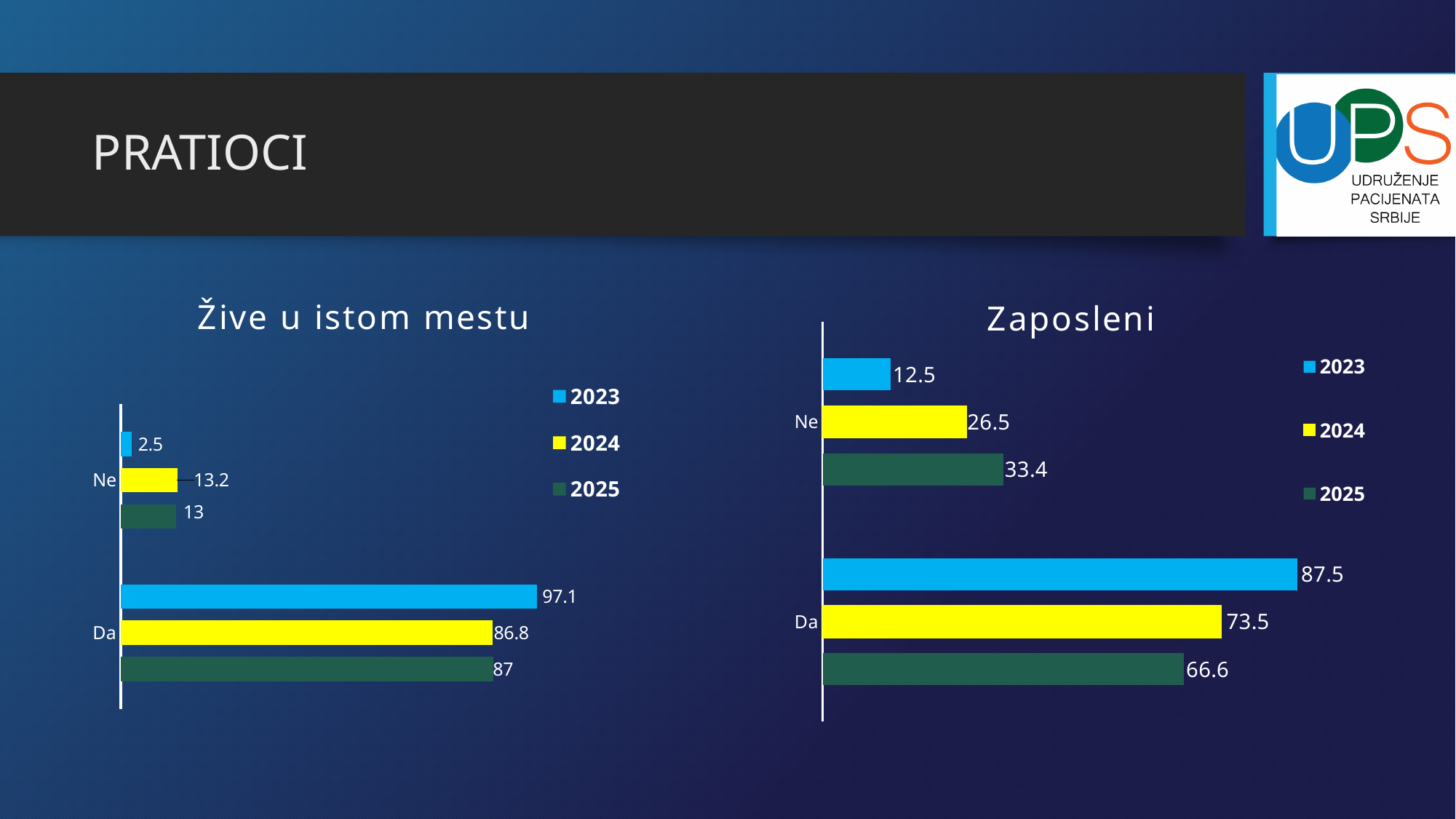
How many series does the legend of the 'Zaposleni' chart list? 3 In the 'Zaposleni' chart, what is the value for 'Ne' in 2025? 33.4 In the 'Žive u istom mestu' chart, what is the value for 'Da' in 2023? 97.1 In the 'Žive u istom mestu' chart, what is the value for 'Ne' in 2024? 13.2 In the 'Žive u istom mestu' chart, which year has the lowest value for 'Ne'? 2023 In the 'Zaposleni' chart, which year has the highest value for 'Da'? 2023 In the 'Zaposleni' chart, which colour represents the 2024 series? Yellow In the 'Zaposleni' chart, which is larger for 'Ne': the 2024 value or the 2025 value? 2025 What kind of chart is the 'Žive u istom mestu' chart? Bar chart In the 'Žive u istom mestu' chart, what is the difference between the 2023 and 2024 values for 'Da'? 10.3 In the 'Zaposleni' chart, what is the value for 'Da' in 2024? 73.5 In the 'Zaposleni' chart, what is the difference between the 2023 and 2025 values for 'Da'? 20.9